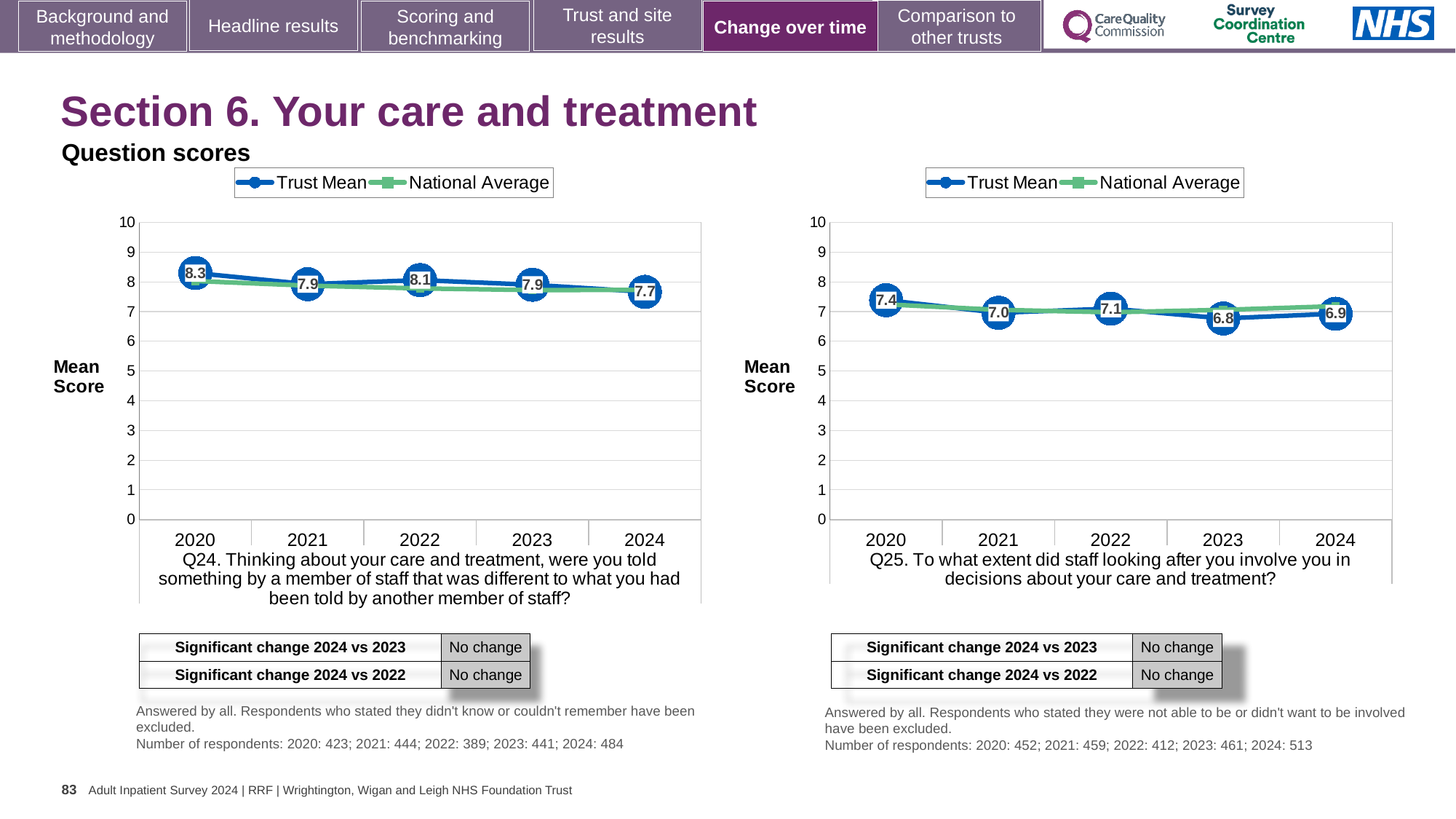
What kind of chart is the Q24 chart on the left? Line chart In the Q25 chart on the right, is the National Average value for 2024 greater or less than 5? greater In the Q24 chart on the left, what is the Trust Mean score for 2024? 7.7 In the Q25 chart on the right, which is larger, the Trust Mean score for 2020 or for 2021? 2020 In the Q24 chart on the left, what is the Trust Mean score for 2020? 8.3 How many series does the legend of the Q25 chart on the right list? 2 In the Q24 chart on the left, which year has the highest Trust Mean score? 2020 How many years are plotted on the x axis of the Q24 chart on the left? 5 In the Q25 chart on the right, what is the difference between the Trust Mean scores for 2020 and 2023? 0.6 In the Q25 chart on the right, what is the Trust Mean score for 2022? 7.1 In the Q24 chart on the left, what is the difference between the Trust Mean scores for 2020 and 2024? 0.6 In the Q25 chart on the right, which year has the lowest Trust Mean score? 2023